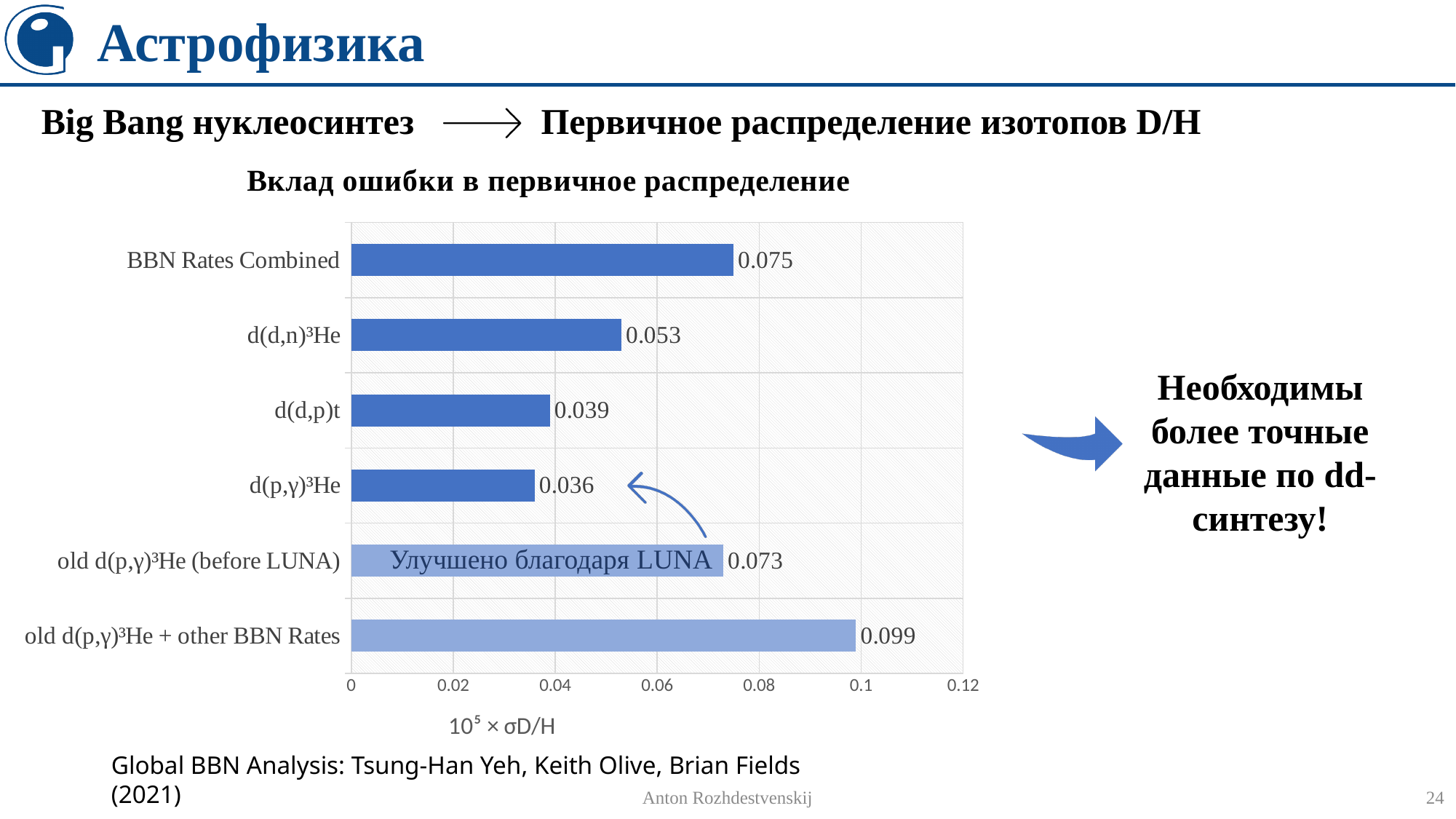
What is the value for old d(p,γ)³He (before LUNA)? 0.073 What is the difference between the values for BBN Rates Combined and d(d,n)³He? 0.022 How many categories are shown in the chart? 6 Which category has the highest value? old d(p,γ)³He + other BBN Rates What is the value for BBN Rates Combined? 0.075 What is the title of the chart? Вклад ошибки в первичное распределение What is the value for d(d,p)t? 0.039 What is the value for d(d,n)³He? 0.053 Which category has the lowest value? d(p,γ)³He What kind of chart is shown on the slide? bar chart Which is larger, the value for d(d,n)³He or the value for d(d,p)t? d(d,n)³He What is the difference between the values for old d(p,γ)³He (before LUNA) and d(p,γ)³He? 0.037